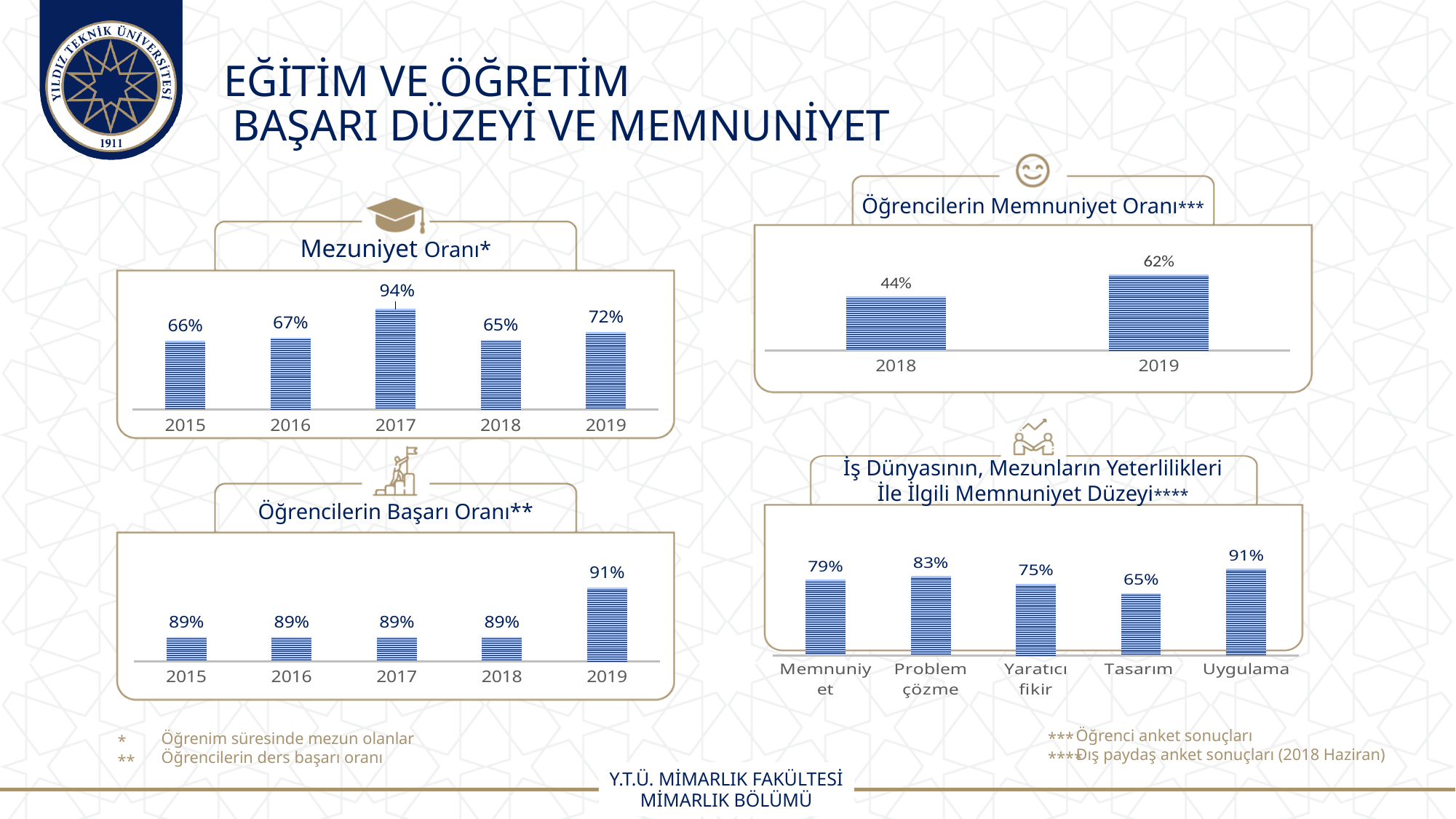
In the 'Öğrencilerin Memnuniyet Oranı' chart, how many years are shown? 2 In the 'Mezuniyet Oranı' chart, which year has the lowest value? 2018 In the 'Öğrencilerin Başarı Oranı' chart, which year has the highest value? 2019 In the 'Öğrencilerin Memnuniyet Oranı' chart, what is the difference between 2019 and 2018? 18% In the 'Mezuniyet Oranı' chart, what is the difference between the values for 2019 and 2015? 6% In the 'İş Dünyasının, Mezunların Yeterlilikleri İle İlgili Memnuniyet Düzeyi' chart, which is larger, Problem çözme or Yaratıcı fikir? Problem çözme In the 'İş Dünyasının, Mezunların Yeterlilikleri İle İlgili Memnuniyet Düzeyi' chart, which category has the highest value? Uygulama In the 'Öğrencilerin Memnuniyet Oranı' chart, what is the value for 2018? 44% In the 'Mezuniyet Oranı' chart, what is the value for 2017? 94% In the 'Öğrencilerin Başarı Oranı' chart, what is the value for 2019? 91% What type of chart is the 'Mezuniyet Oranı' chart? Bar chart In the 'İş Dünyasının, Mezunların Yeterlilikleri İle İlgili Memnuniyet Düzeyi' chart, what is the value for Tasarım? 65%